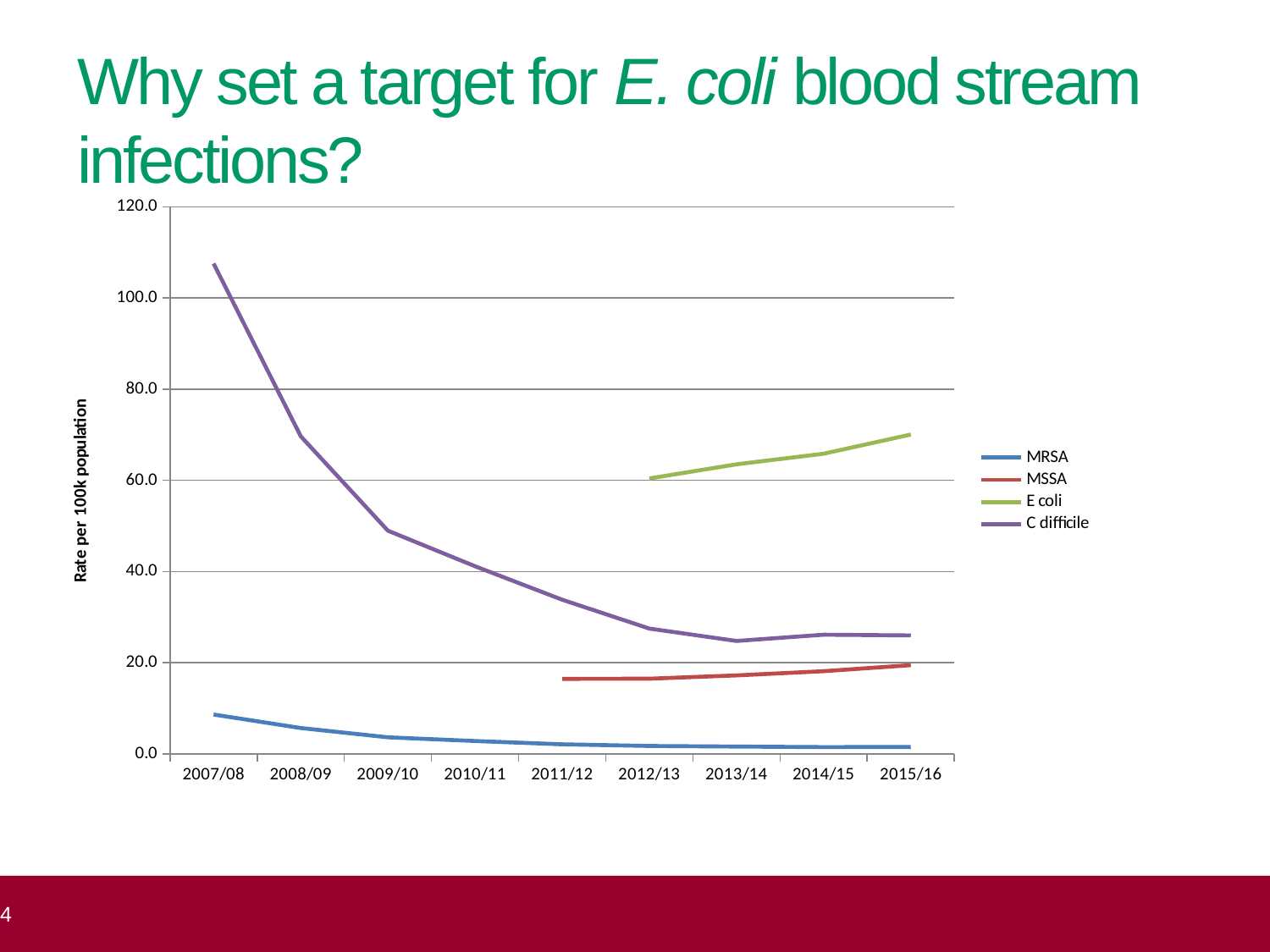
Does the C difficile line rise or fall from 2007/08 to 2015/16? fall Is the value for C difficile in 2007/08 greater or less than 100? greater Does the E coli line rise or fall from 2012/13 to 2015/16? rise How many series does the legend list? 4 Which series has the lowest value in 2015/16? MRSA What kind of chart is shown on the slide? line chart In 2015/16, which is larger: E coli or C difficile? E coli Is the value for MSSA in 2011/12 greater or less than 20? less How many time periods are shown on the x axis? 9 Which series has the highest value in 2007/08? C difficile Is the value for E coli in 2015/16 greater or less than 60? greater